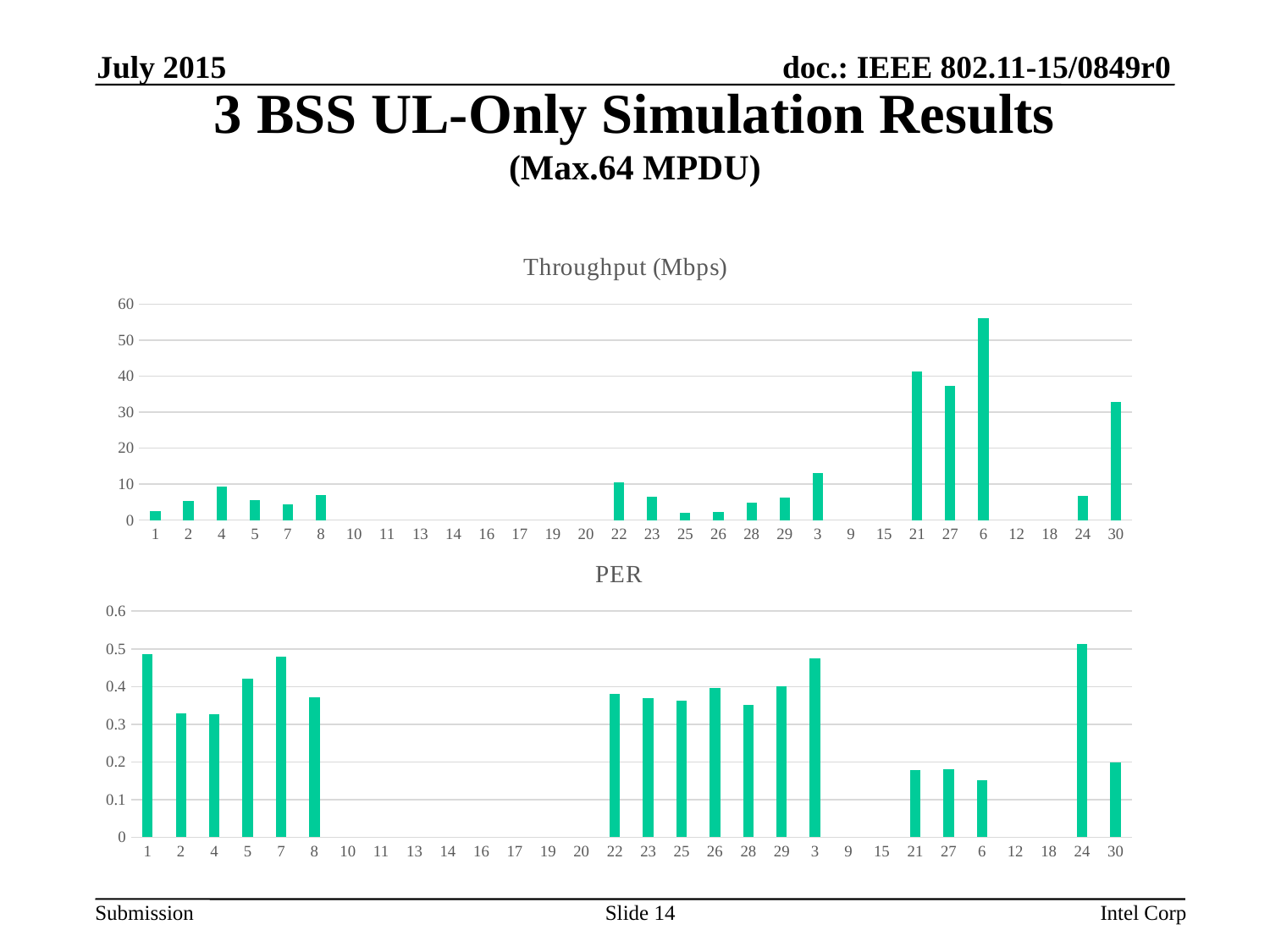
What kind of chart is the Throughput (Mbps) chart? bar chart In the PER chart, is the value for category 2 greater or less than 0.4? less In the Throughput (Mbps) chart, which has the larger value, category 21 or category 30? 21 In the PER chart, which has the larger value, category 7 or category 8? 7 In the PER chart, is the value for category 1 greater or less than 0.4? greater In the Throughput (Mbps) chart, is the value for category 6 greater or less than 50? greater In the Throughput (Mbps) chart, which category has the highest throughput? 6 How many categories are shown on the x axis of the Throughput (Mbps) chart? 30 What is the title of the top chart on the slide? Throughput (Mbps)